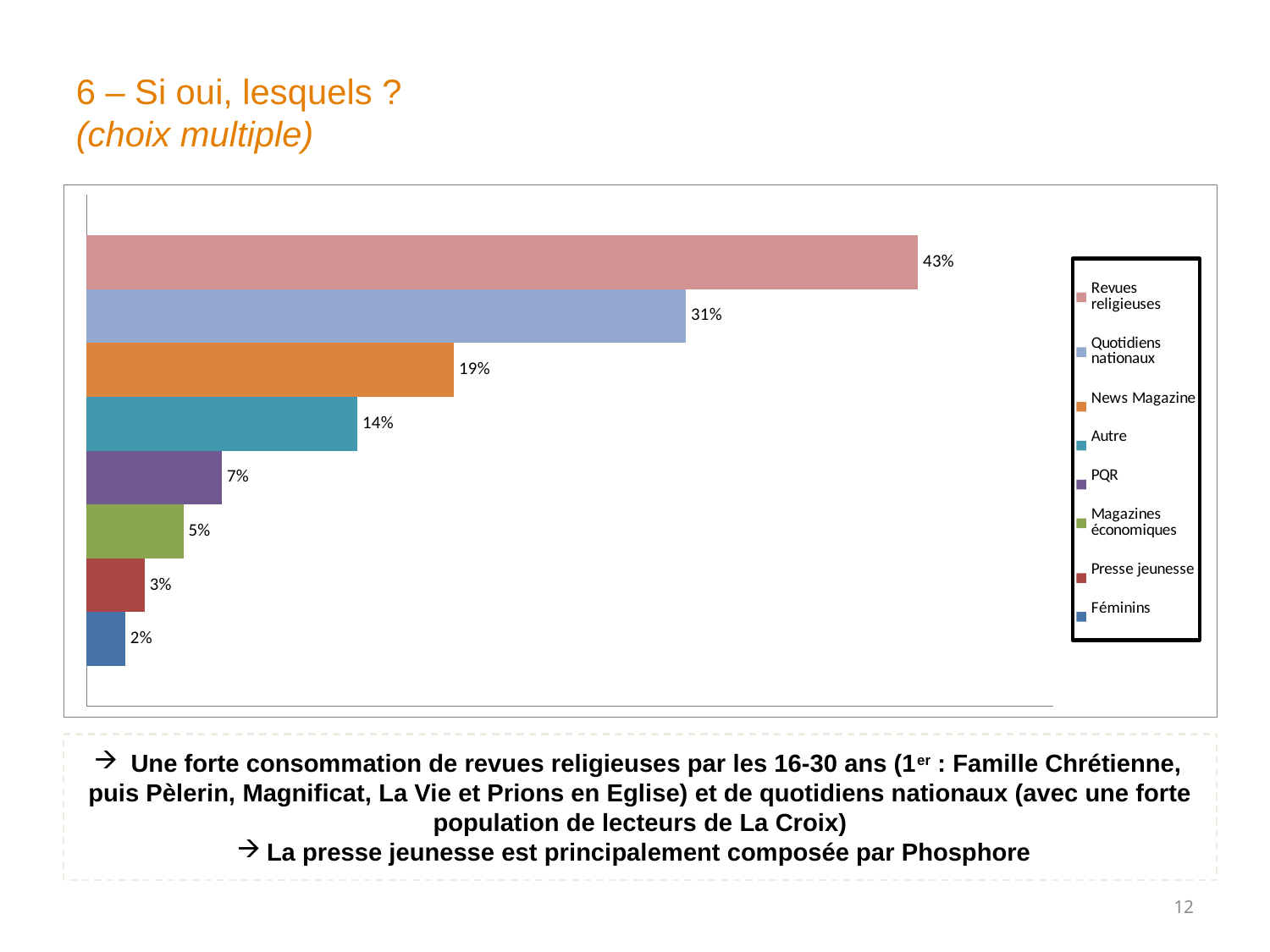
What is the difference in percentage points between Revues religieuses and Quotidiens nationaux? 12 How many entries does the legend list? 8 What percentage is shown for Revues religieuses? 43% Which category has the lowest percentage? Féminins What percentage is shown for Presse jeunesse? 3% Which is larger, the value for Autre or the value for PQR? Autre What percentage is shown for News Magazine? 19% How many categories are shown in the chart? 8 What percentage is shown for Quotidiens nationaux? 31% What kind of chart is shown on the slide? Bar chart What colour is the bar for Magazines économiques? Green Which category has the highest percentage? Revues religieuses